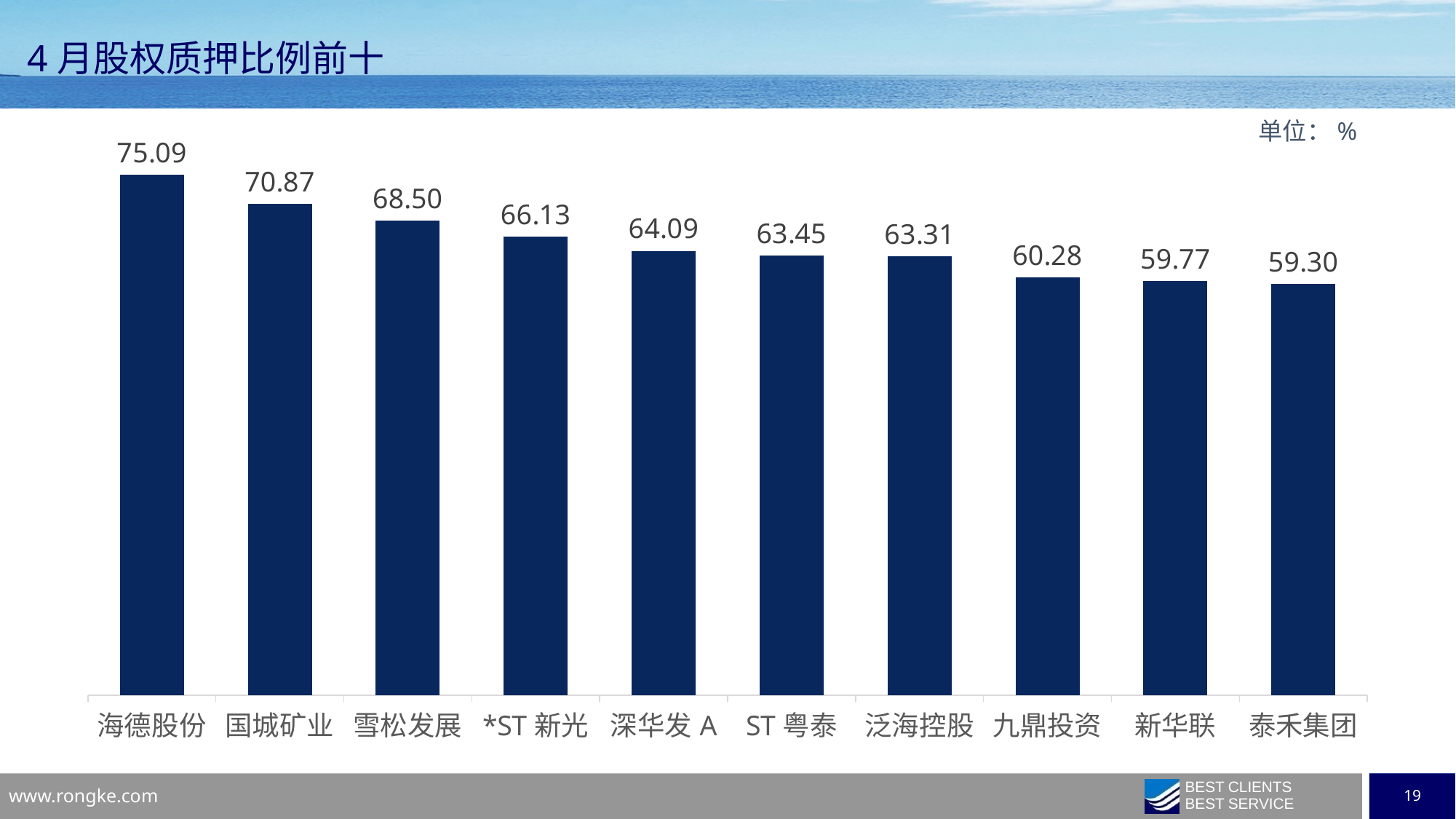
What is the difference between the values for 海德股份 and 国城矿业? 4.22 What kind of chart is shown on the slide? bar chart What is the title of the chart? 4 月股权质押比例前十 Do the values rise or fall from left to right along the x axis? fall What is the value for 海德股份? 75.09 What is the difference between the values for 雪松发展 and 九鼎投资? 8.22 What is the value for 泛海控股? 63.31 Which is larger, the value for *ST 新光 or the value for 深华发 A? *ST 新光 Which category has the highest value? 海德股份 What is the value for 新华联? 59.77 Which category has the lowest value? 泰禾集团 How many categories are shown in the chart? 10